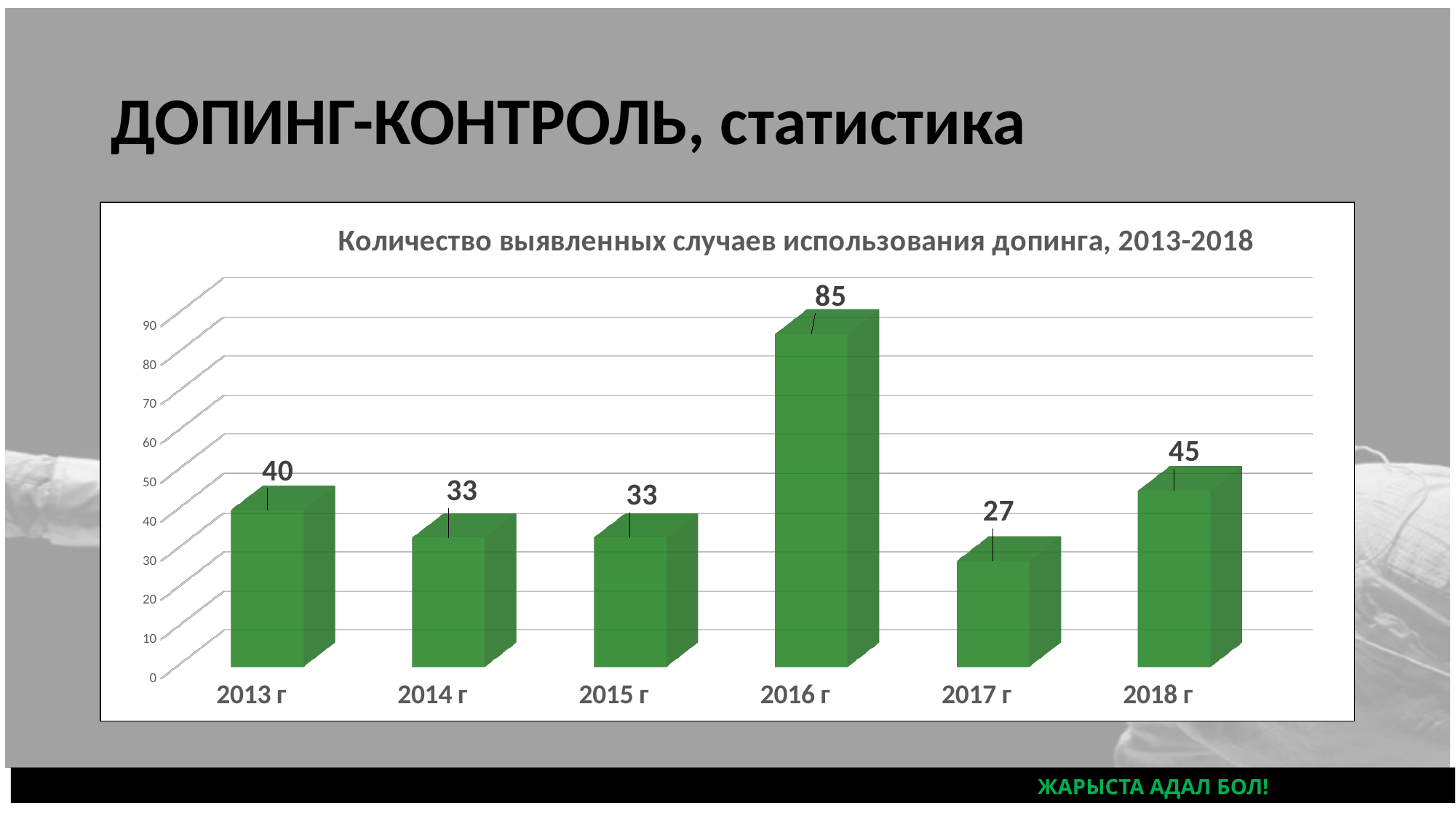
What is the value for 2016 г? 85 Which year has the highest number of detected doping cases? 2016 г What is the value for 2018 г? 45 What is the difference between the values for 2016 г and 2017 г? 58 What is the value for 2017 г? 27 What is the title of the chart? Количество выявленных случаев использования допинга, 2013-2018 Which is larger, the value for 2013 г or the value for 2018 г? 2018 г Which year has the lowest number of detected doping cases? 2017 г What kind of chart is shown on the slide? bar chart Do the values rise or fall from 2016 г to 2017 г? fall How many years are shown on the x axis? 6 What is the value for 2013 г? 40